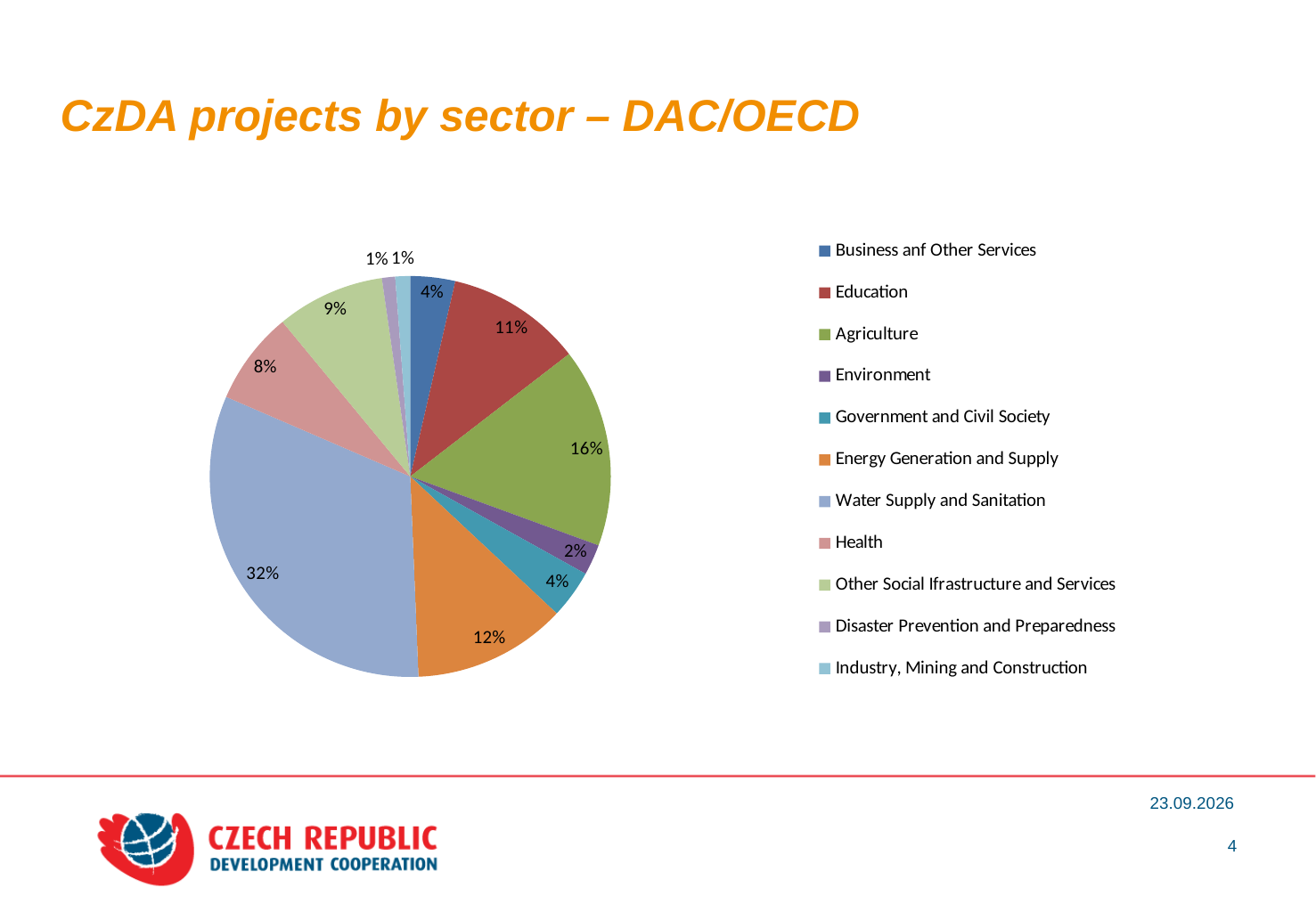
Which sector has the largest share of the pie? Water Supply and Sanitation What is the difference in percentage points between Water Supply and Sanitation and Agriculture? 16 How many sectors does the legend list? 11 What is the share for Environment? 2% What is the title of the slide containing the chart? CzDA projects by sector – DAC/OECD What is the share for Government and Civil Society? 4% What type of chart is shown on the slide? Pie chart Which is larger, the share for Health or the share for Other Social Ifrastructure and Services? Other Social Ifrastructure and Services What share of CzDA projects is in Water Supply and Sanitation? 32% What percentage is shown for Education? 11% What percentage is shown for Energy Generation and Supply? 12%